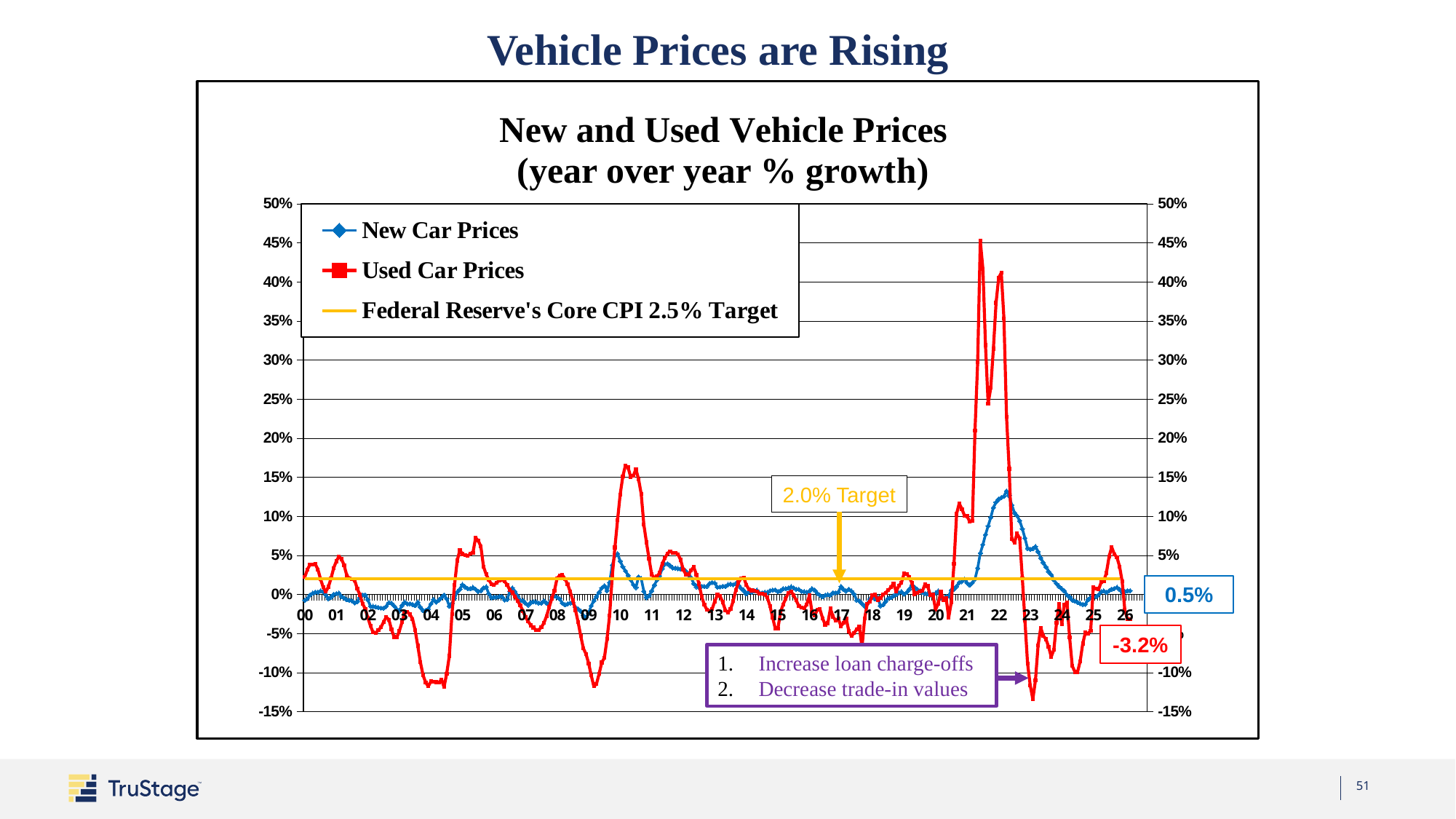
What is the latest labelled value for New Car Prices? 0.5% Is the lowest value for Used Car Prices around 2023 greater or less than -10%? less What is the difference between the latest labelled values for New Car Prices (0.5%) and Used Car Prices (-3.2%)? 3.7 percentage points What is the latest labelled value for Used Car Prices? -3.2% What kind of chart is shown on the slide? line chart Which series reaches the highest value anywhere on the chart? Used Car Prices Is the peak value for Used Car Prices around 2021 greater or less than 40%? greater Which series has the higher latest labelled value, New Car Prices or Used Car Prices? New Car Prices How many series does the legend list? 3 What is the title of the chart? New and Used Vehicle Prices (year over year % growth) What does the legend call the yellow horizontal line? Federal Reserve's Core CPI 2.5% Target Is the peak value for New Car Prices around 2022 greater or less than 10%? greater